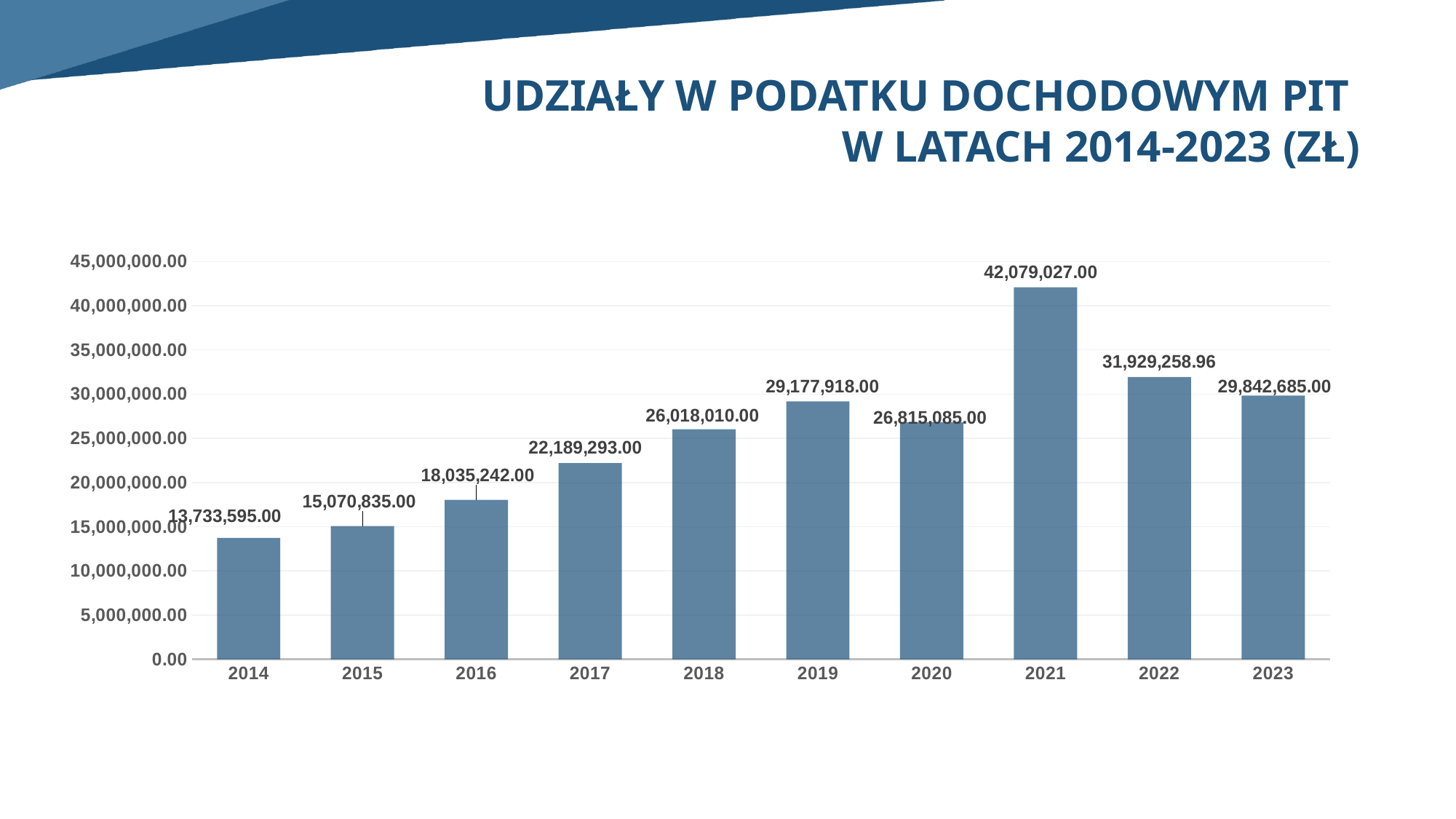
What is the value for 2014? 13,733,595.00 Which year has the highest value? 2021 What is the title of the chart? UDZIAŁY W PODATKU DOCHODOWYM PIT W LATACH 2014-2023 (ZŁ) What is the value for 2021? 42,079,027.00 Is the value for 2017 greater or less than 20,000,000.00? greater Which year has the lowest value? 2014 How many years are shown on the x axis? 10 What is the value for 2022? 31,929,258.96 What is the difference between the values for 2015 and 2014? 1,337,240.00 What kind of chart is shown on the slide? bar chart What is the difference between the values for 2021 and 2020? 15,263,942.00 Which is larger, the value for 2019 or the value for 2020? 2019